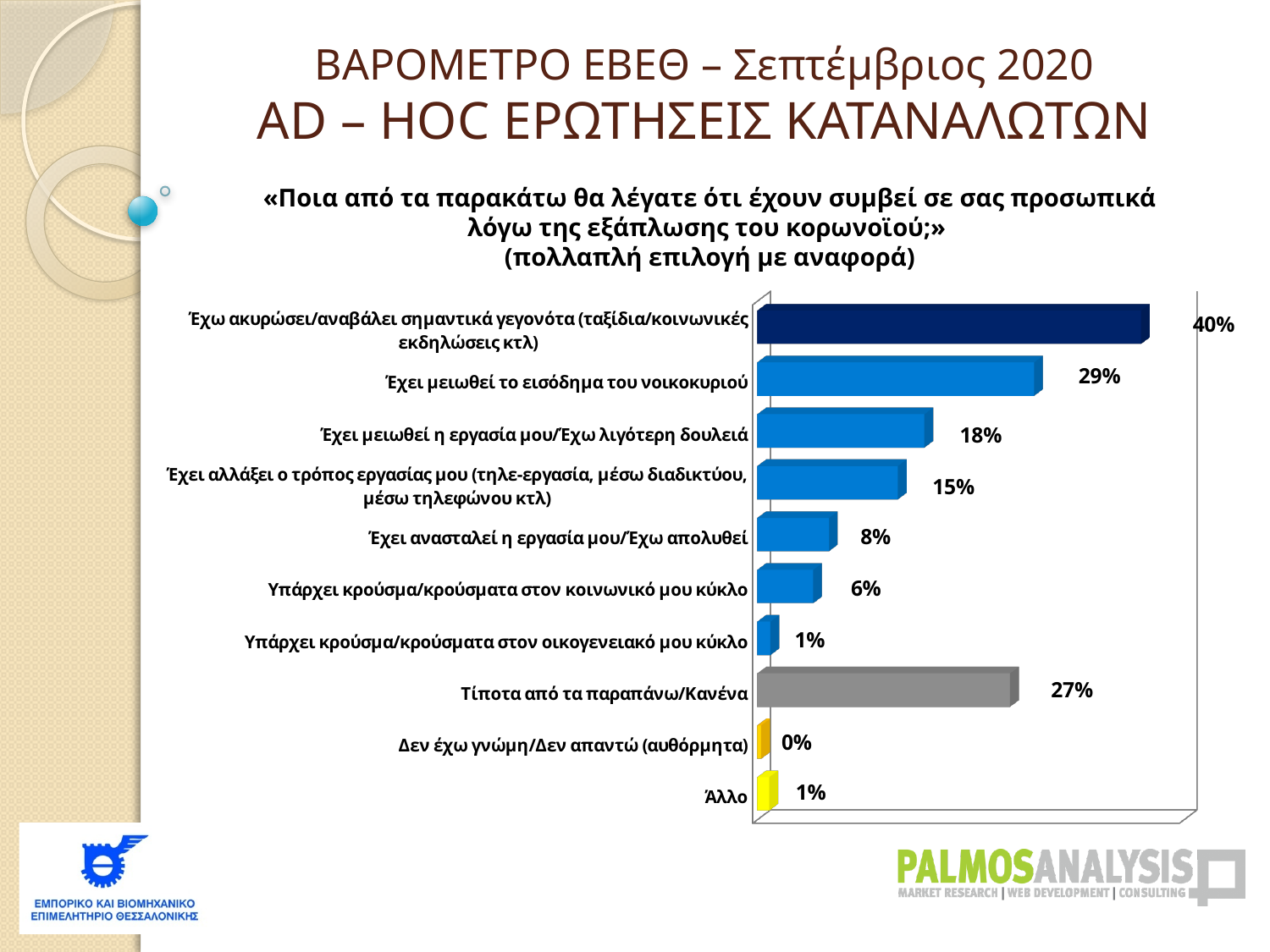
What is the difference between the value for 'Έχω ακυρώσει/αναβάλει σημαντικά γεγονότα' and the value for 'Έχει μειωθεί το εισόδημα του νοικοκυριού'? 11% What percentage of respondents said their household income has decreased (Έχει μειωθεί το εισόδημα του νοικοκυριού)? 29% What colour is the bar for 'Τίποτα από τα παραπάνω/Κανένα'? Grey Which category has the highest value in the chart? Έχω ακυρώσει/αναβάλει σημαντικά γεγονότα (ταξίδια/κοινωνικές εκδηλώσεις κτλ) Which category has the lowest value in the chart? Δεν έχω γνώμη/Δεν απαντώ (αυθόρμητα) What is the value for 'Υπάρχει κρούσμα/κρούσματα στον κοινωνικό μου κύκλο'? 6% How many categories are shown in the chart? 10 Which is larger: the value for 'Τίποτα από τα παραπάνω/Κανένα' or the value for 'Έχει μειωθεί η εργασία μου/Έχω λιγότερη δουλειά'? Τίποτα από τα παραπάνω/Κανένα What is the value for 'Τίποτα από τα παραπάνω/Κανένα'? 27% What type of chart is shown on the slide? Bar chart What is the difference between 'Έχει μειωθεί η εργασία μου/Έχω λιγότερη δουλειά' and 'Έχει ανασταλεί η εργασία μου/Έχω απολυθεί'? 10% What percentage is shown for 'Έχει αλλάξει ο τρόπος εργασίας μου (τηλε-εργασία, μέσω διαδικτύου, μέσω τηλεφώνου κτλ)'? 15%